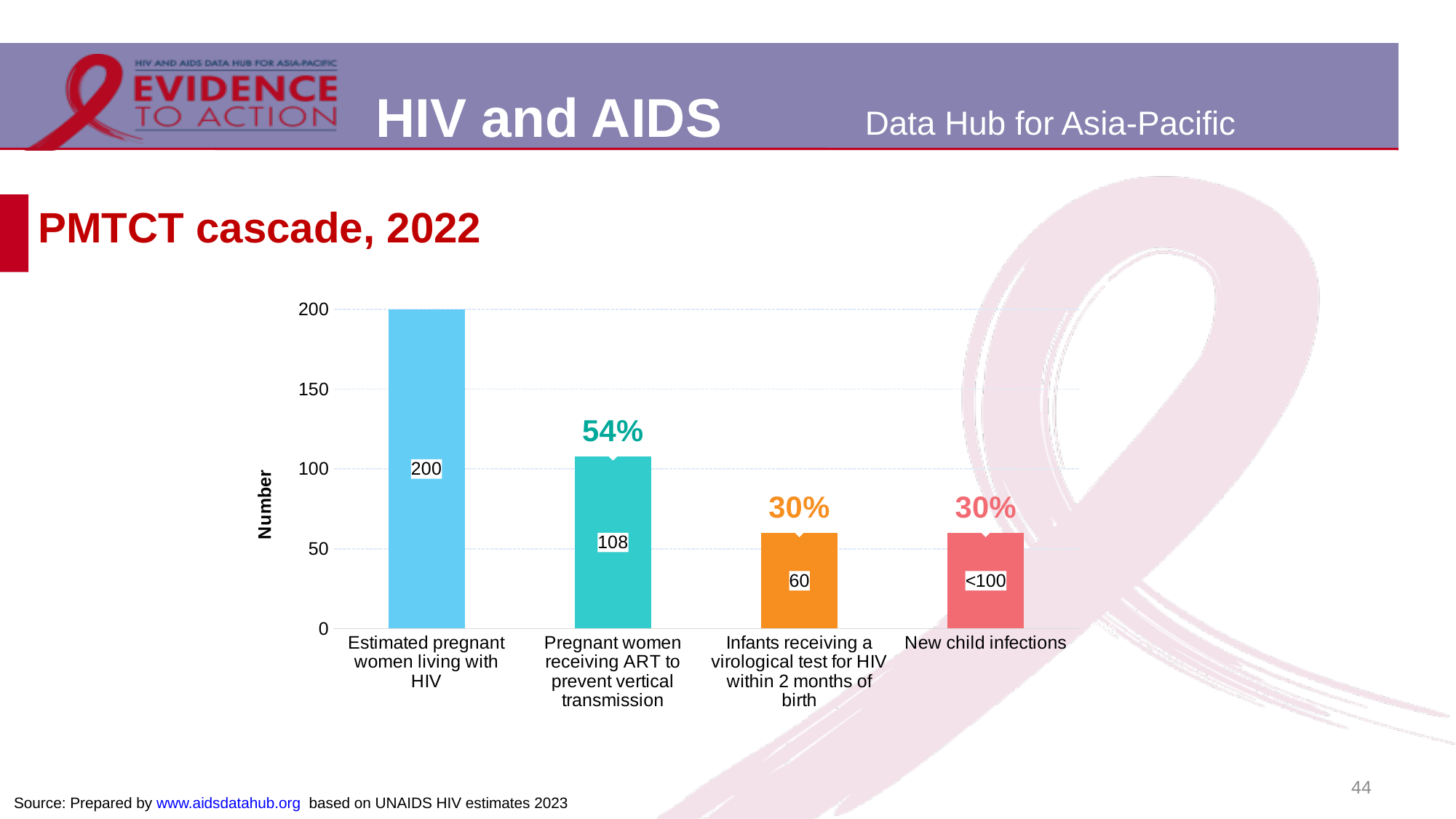
What percentage is shown above the Infants receiving a virological test for HIV within 2 months of birth bar? 30% How many categories are shown on the x axis of the chart? 4 What is the difference between the value for Estimated pregnant women living with HIV and the value for Pregnant women receiving ART to prevent vertical transmission? 92 What is the value for Infants receiving a virological test for HIV within 2 months of birth? 60 What is the title of the chart? PMTCT cascade, 2022 What value is labelled on the New child infections bar? <100 What is the value for Pregnant women receiving ART to prevent vertical transmission? 108 Which is larger: the value for Pregnant women receiving ART to prevent vertical transmission or the value for Infants receiving a virological test for HIV within 2 months of birth? Pregnant women receiving ART to prevent vertical transmission What percentage is shown above the Pregnant women receiving ART to prevent vertical transmission bar? 54% What type of chart is shown on the slide? bar chart What is the value for Estimated pregnant women living with HIV? 200 Which category has the highest value? Estimated pregnant women living with HIV